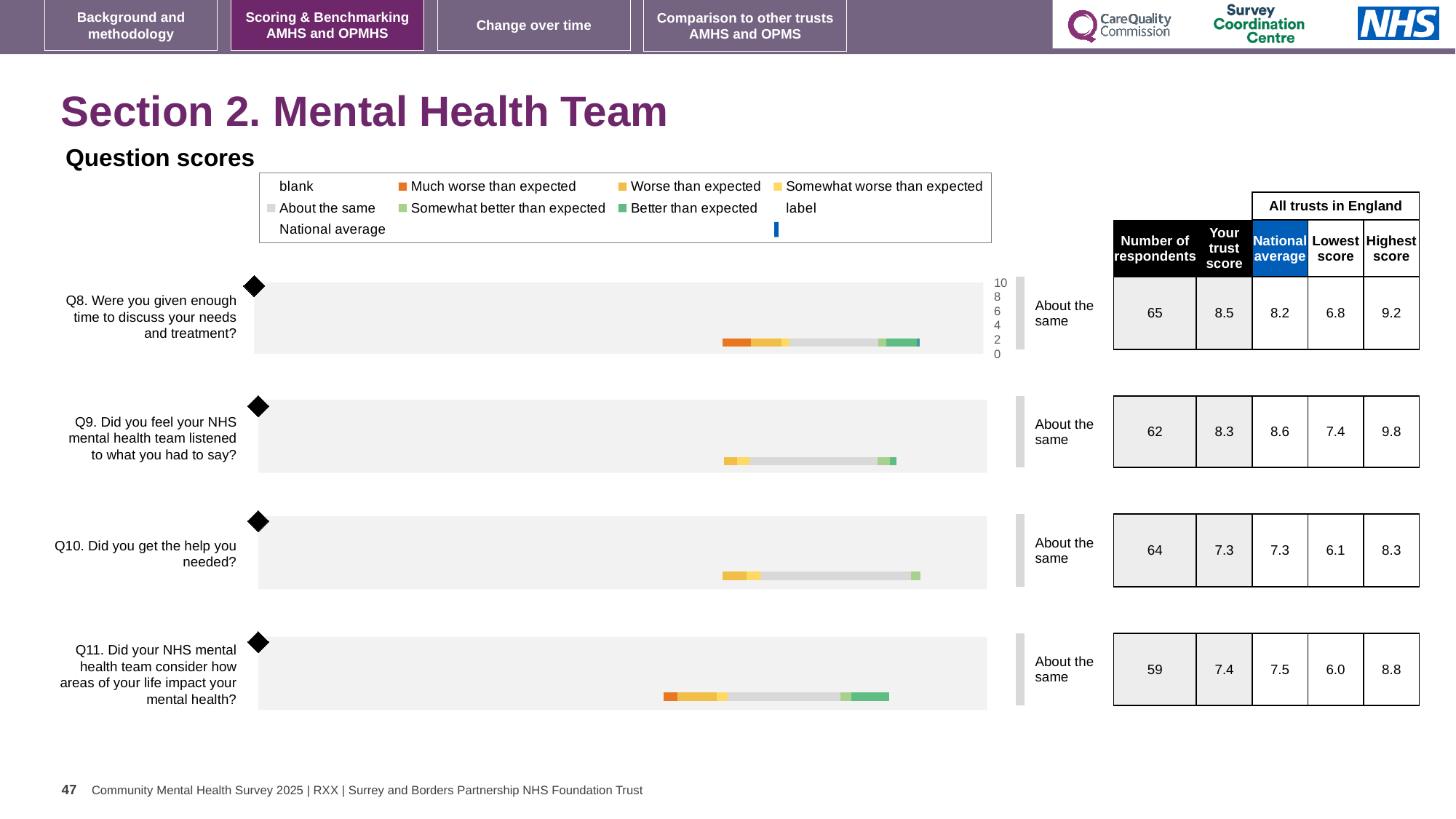
In the legend, which colour represents 'Much worse than expected'? Orange For the Q8 chart, which is larger: your trust score or the national average? Your trust score For the Q9 chart (mental health team listened to what you had to say), what is your trust score? 8.3 For the Q10 chart (did you get the help you needed), what is the national average? 7.3 What kind of chart is used to show the question scores for Q8 to Q11? Bar chart Which question has the highest 'Your trust score'? Q8 For the Q10 chart, what benchmark category is the trust's result labelled as? About the same In the legend, which colour represents 'Better than expected'? Green Which question has the lowest number of respondents? Q11 For the Q9 chart, what is the difference between the highest score and the lowest score across all trusts in England? 2.4 How many question charts (Q8 to Q11) are shown on the slide? 4 For the Q8 chart (time to discuss your needs and treatment), what is the number of respondents? 65